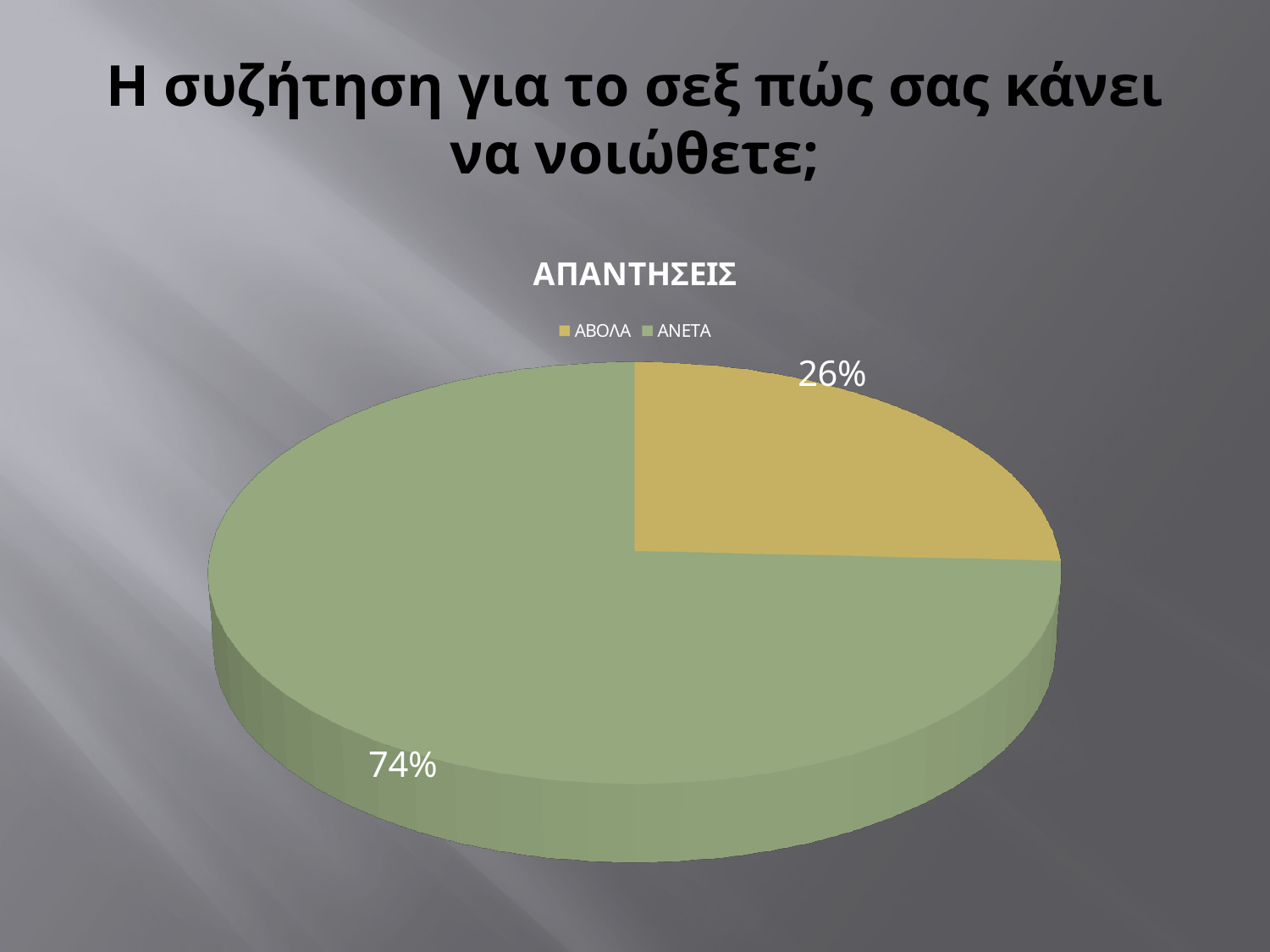
Which category has the largest slice? ΑΝΕΤΑ Which category has the smallest slice? ΑΒΟΛΑ What is the chart's title? ΑΠΑΝΤΗΣΕΙΣ How many categories does the pie chart have? 2 How many entries does the legend list? 2 Which is larger, the ΑΒΟΛΑ slice or the ΑΝΕΤΑ slice? ΑΝΕΤΑ What colour is the ΑΝΕΤΑ slice? green What is the difference in percentage points between ΑΝΕΤΑ and ΑΒΟΛΑ? 48 What type of chart is shown on the slide? pie chart What share of the pie does ΑΒΟΛΑ represent? 26% What share of the pie does ΑΝΕΤΑ represent? 74%